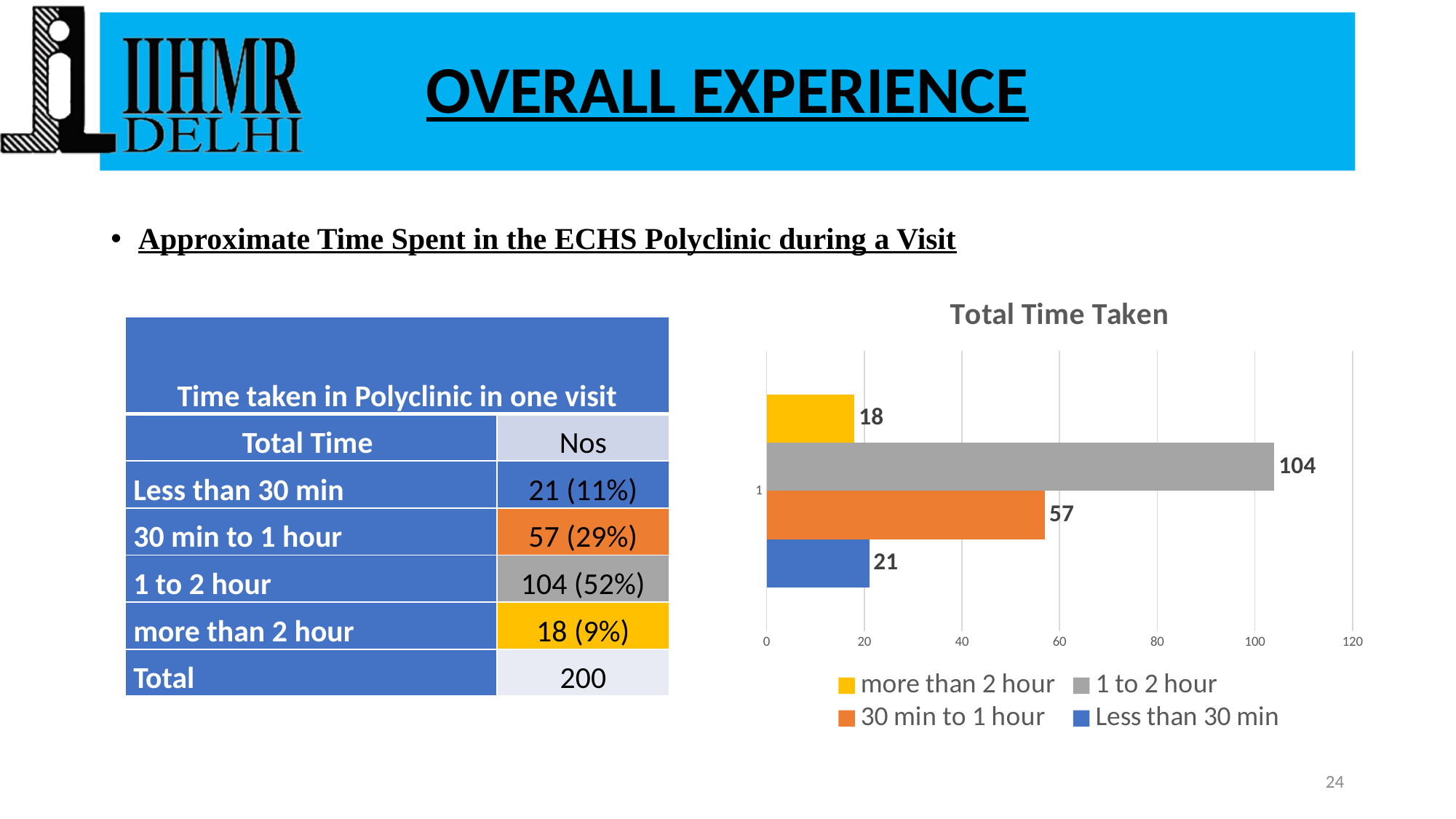
What colour is the bar for '1 to 2 hour' in the Total Time Taken chart? grey What is the value for '1 to 2 hour' in the Total Time Taken chart? 104 What is the value for '30 min to 1 hour' in the Total Time Taken chart? 57 What kind of chart is the Total Time Taken chart? bar chart How many series does the legend of the Total Time Taken chart list? 4 What is the value for 'Less than 30 min' in the Total Time Taken chart? 21 Which series has the highest value in the Total Time Taken chart? 1 to 2 hour Which is larger in the Total Time Taken chart: 'Less than 30 min' or 'more than 2 hour'? Less than 30 min Is the value for '30 min to 1 hour' in the Total Time Taken chart greater or less than 60? less Which series has the lowest value in the Total Time Taken chart? more than 2 hour What is the value for 'more than 2 hour' in the Total Time Taken chart? 18 What is the difference between the values for '1 to 2 hour' and '30 min to 1 hour' in the Total Time Taken chart? 47